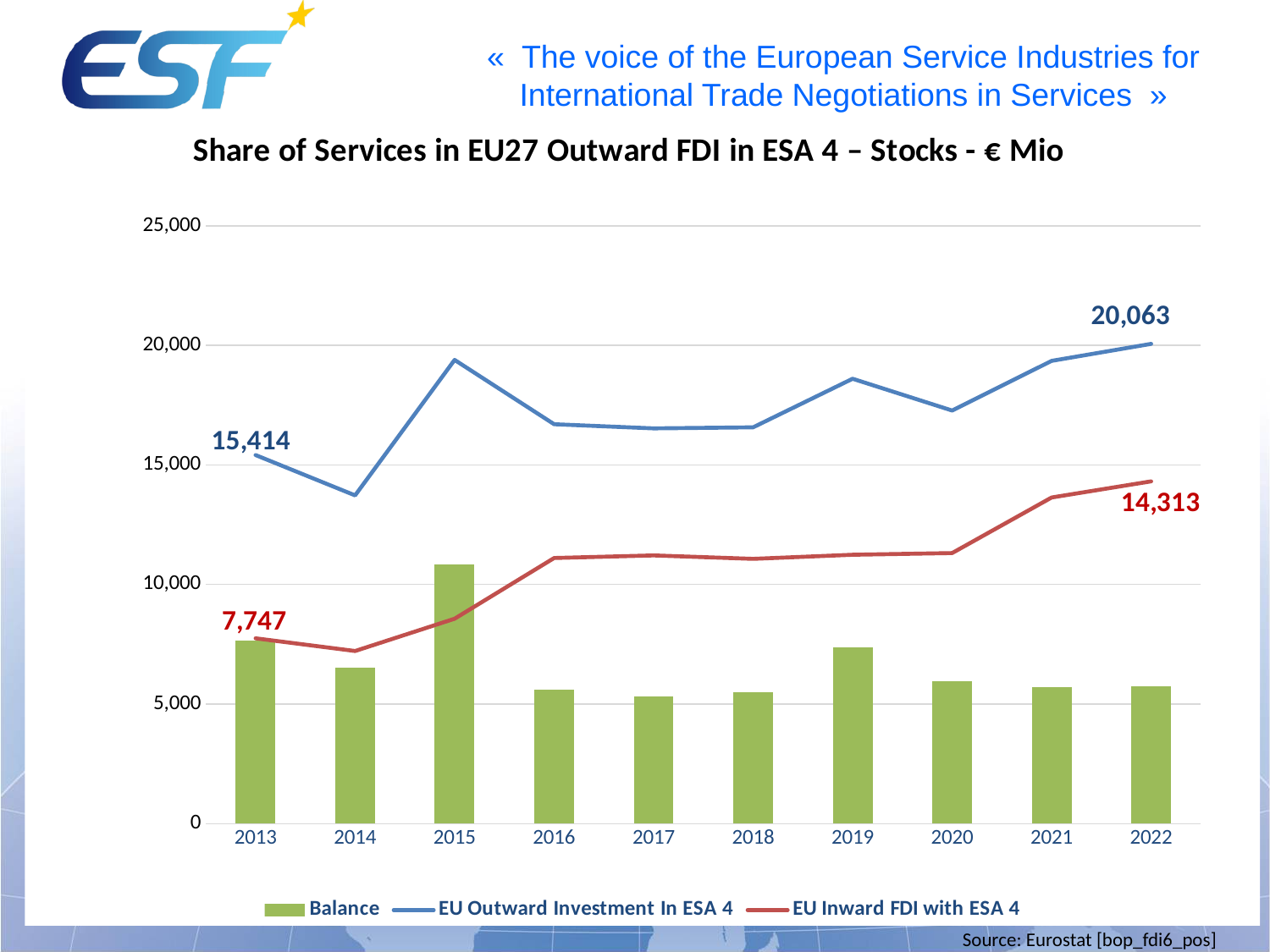
What is the difference between EU Outward Investment In ESA 4 and EU Inward FDI with ESA 4 in 2022? 5,750 How many years are shown on the x axis? 10 In which year is the Balance bar the highest? 2015 By how much did EU Outward Investment In ESA 4 increase from 2013 to 2022? 4,649 How many series does the legend list? 3 What is the value of EU Inward FDI with ESA 4 in 2022? 14,313 What is the value of EU Outward Investment In ESA 4 in 2022? 20,063 What is the value of EU Outward Investment In ESA 4 in 2013? 15,414 In 2022, which is larger: EU Outward Investment In ESA 4 or EU Inward FDI with ESA 4? EU Outward Investment In ESA 4 Does the EU Inward FDI with ESA 4 line rise or fall overall from 2013 to 2022? rise What is the value of EU Inward FDI with ESA 4 in 2013? 7,747 Is the Balance value for 2015 greater or less than 10,000? greater